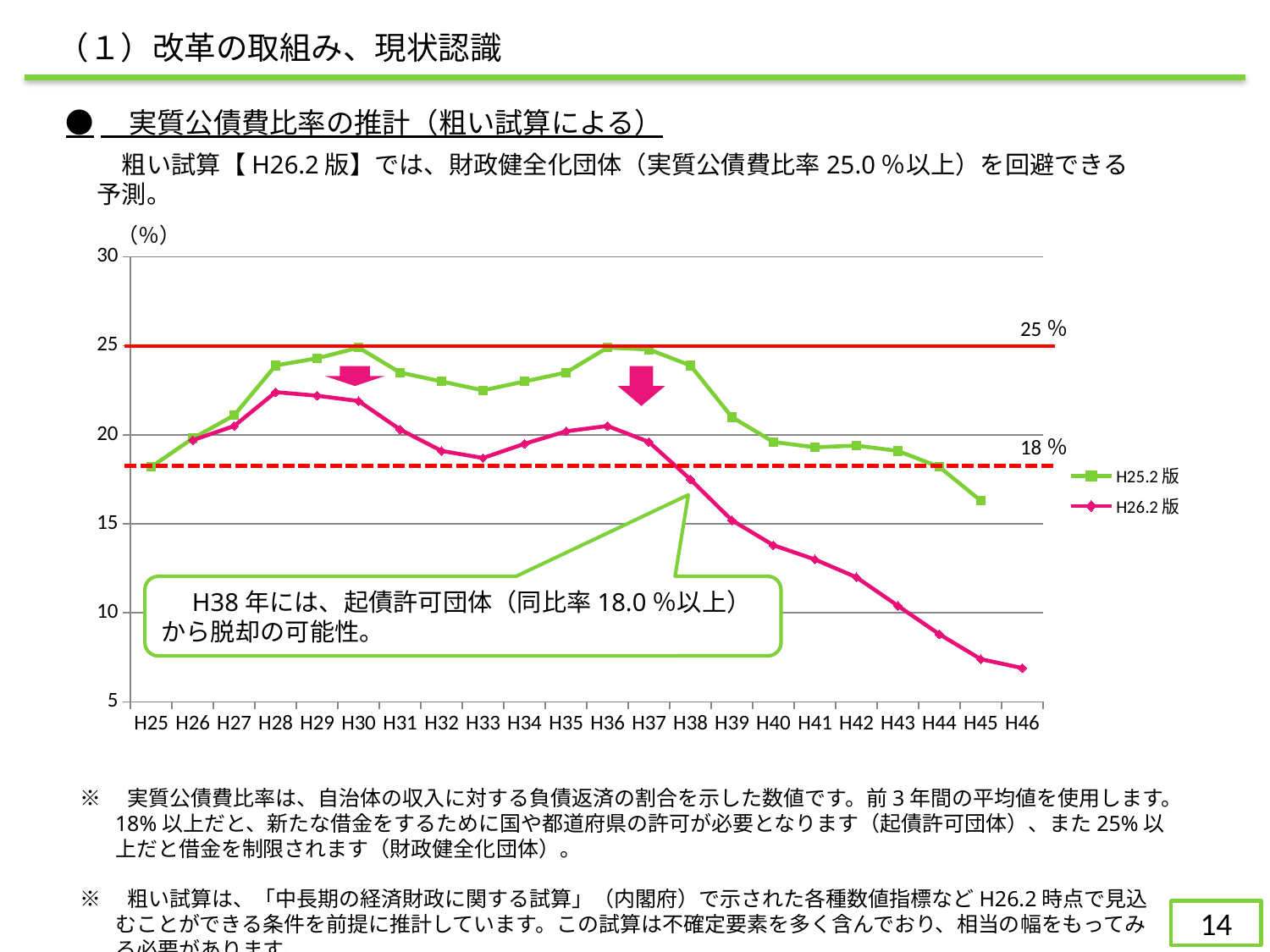
Does the H26.2版 series rise or fall from H36 to H46? fall What kind of chart is shown on the slide? line chart How many years (categories) are shown on the x axis? 22 At which year is the H25.2版 series lowest? H45 Is the value for H25.2版 at H28 greater or less than 20? greater How many series does the legend list? 2 Is the value for H25.2版 at H45 greater or less than 15? greater What are the two series named in the legend? H25.2版 and H26.2版 At which year is the H26.2版 series lowest? H46 Is the value for H26.2版 at H46 greater or less than 10? less At H40, which series has the larger value, H25.2版 or H26.2版? H25.2版